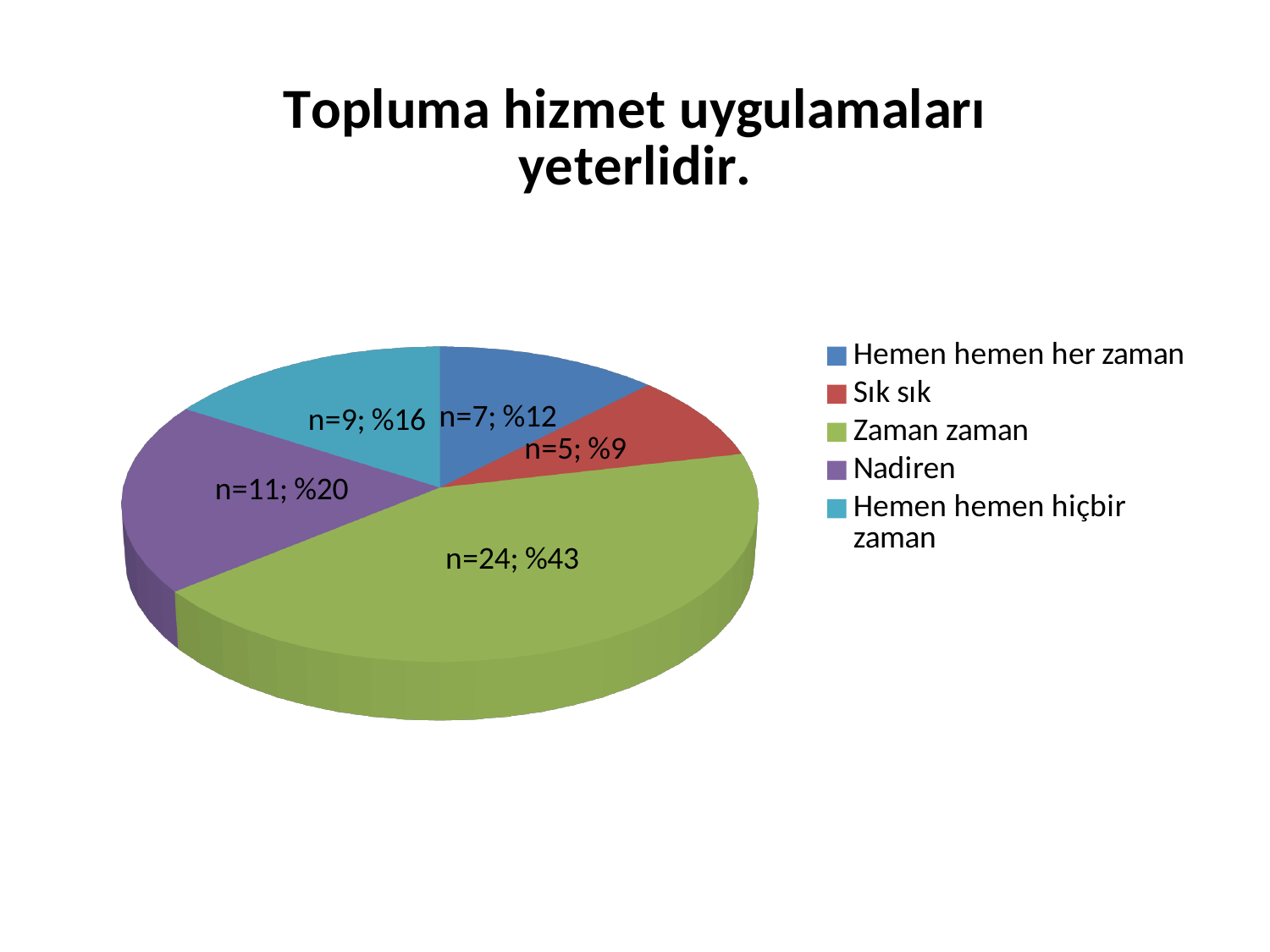
What is the difference in n between 'Zaman zaman' and 'Nadiren'? 13 What is the n value for the 'Hemen hemen hiçbir zaman' slice? n=9 What kind of chart is shown on the slide? pie chart What percentage share does the 'Hemen hemen her zaman' slice have? %12 Which category has the smallest slice? Sık sık How many categories does the legend list? 5 What is the n value for the 'Zaman zaman' slice? n=24 Which has a larger n, 'Hemen hemen hiçbir zaman' or 'Hemen hemen her zaman'? Hemen hemen hiçbir zaman Which category has the largest slice? Zaman zaman What is the n value for the 'Sık sık' slice? n=5 What is the title of the chart? Topluma hizmet uygulamaları yeterlidir. What percentage share does the 'Nadiren' slice have? %20